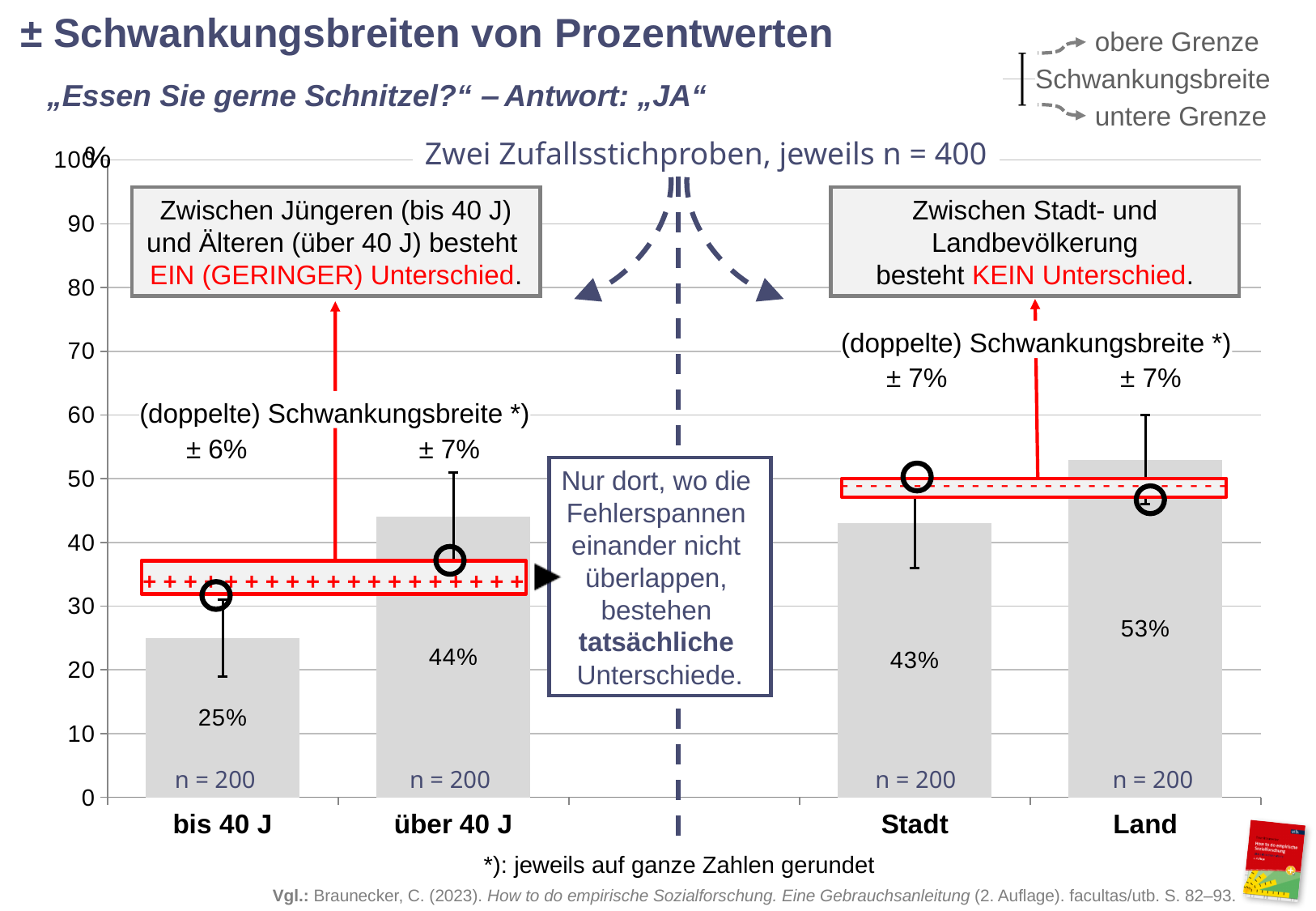
What is the (doppelte) Schwankungsbreite shown for "bis 40 J"? ± 6% What is the value for "bis 40 J"? 25% What kind of chart is shown on the slide? bar chart What is the difference between the values for "über 40 J" and "bis 40 J"? 19% What is the value for "Stadt"? 43% What is the value for "Land"? 53% What is the value for "über 40 J"? 44% Which category has the lowest value? bis 40 J Which is larger, the value for "Stadt" or the value for "Land"? Land Which category has the highest value? Land How many bars (categories) are shown in the chart? 4 What is the difference between the values for "Land" and "Stadt"? 10%